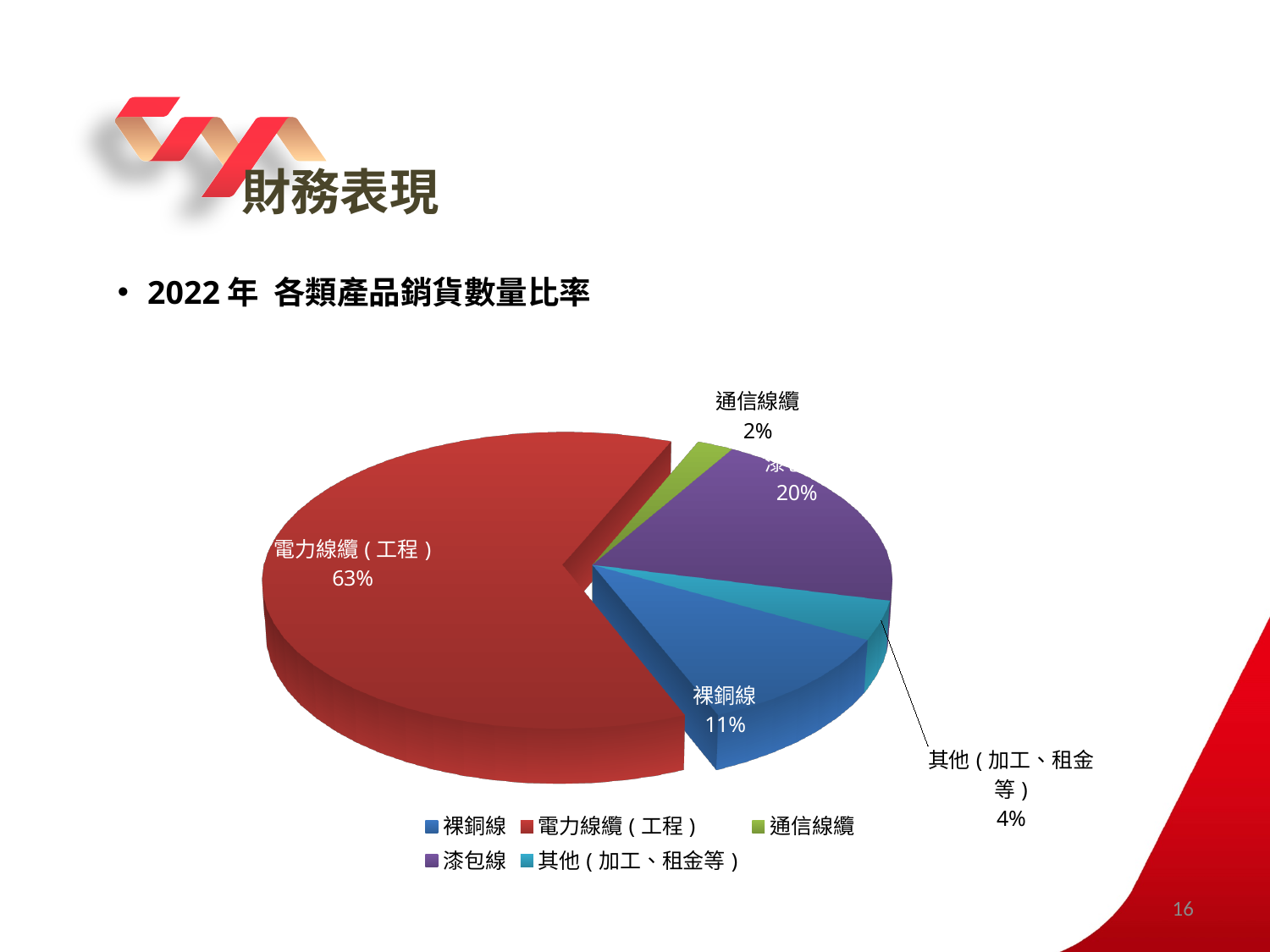
What percentage is shown for 通信線纜? 2% What kind of chart is shown on the slide? Pie chart Which is larger, the share for 裸銅線 or the share for 其他（加工、租金等）? 裸銅線 What percentage is shown for 裸銅線? 11% Which category has the smallest share of the pie? 通信線纜 How many categories does the pie chart show? 5 Which category has the largest share of the pie? 電力線纜（工程） What percentage is shown for 漆包線? 20% What percentage is shown for 其他（加工、租金等）? 4% What share of the pie does 電力線纜（工程） hold? 63% What is the difference in percentage points between 電力線纜（工程） and 漆包線? 43 How many entries does the legend list? 5